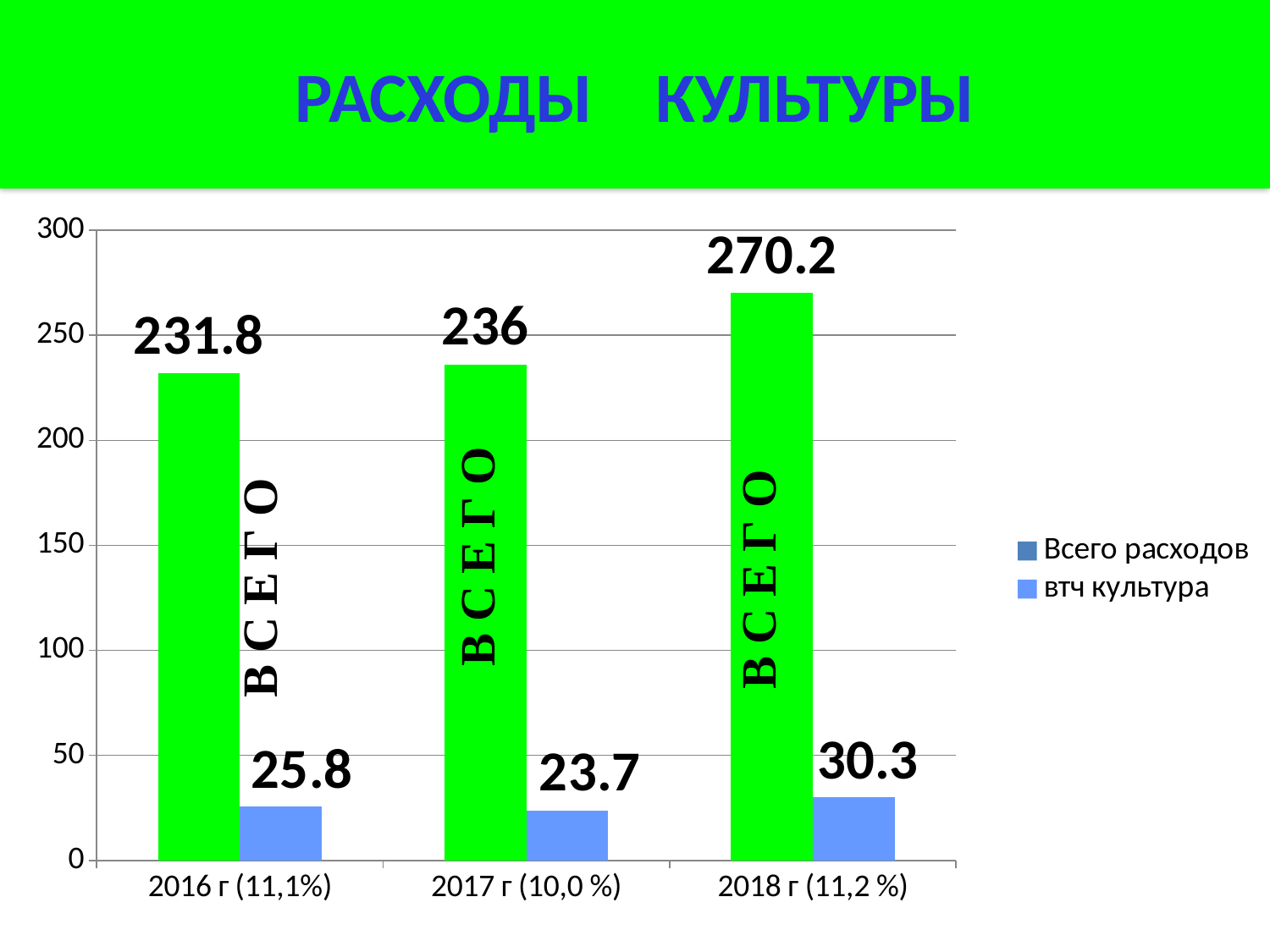
What is the value of втч культура for 2016 г (11,1%)? 25.8 Which year has the lowest value for втч культура? 2017 г (10,0 %) Which year has the highest value for Всего расходов? 2018 г (11,2 %) How many series does the legend list? 2 How many categories are shown on the x axis? 3 What is the value of Всего расходов for 2016 г (11,1%)? 231.8 Is the value of Всего расходов for 2017 г (10,0 %) greater or less than 250? less What is the difference between Всего расходов in 2018 г (11,2 %) and 2017 г (10,0 %)? 34.2 What is the value of втч культура for 2017 г (10,0 %)? 23.7 Which is larger: втч культура in 2016 г (11,1%) or in 2018 г (11,2 %)? 2018 г (11,2 %) What is the value of Всего расходов for 2018 г (11,2 %)? 270.2 What type of chart is shown on the slide? bar chart